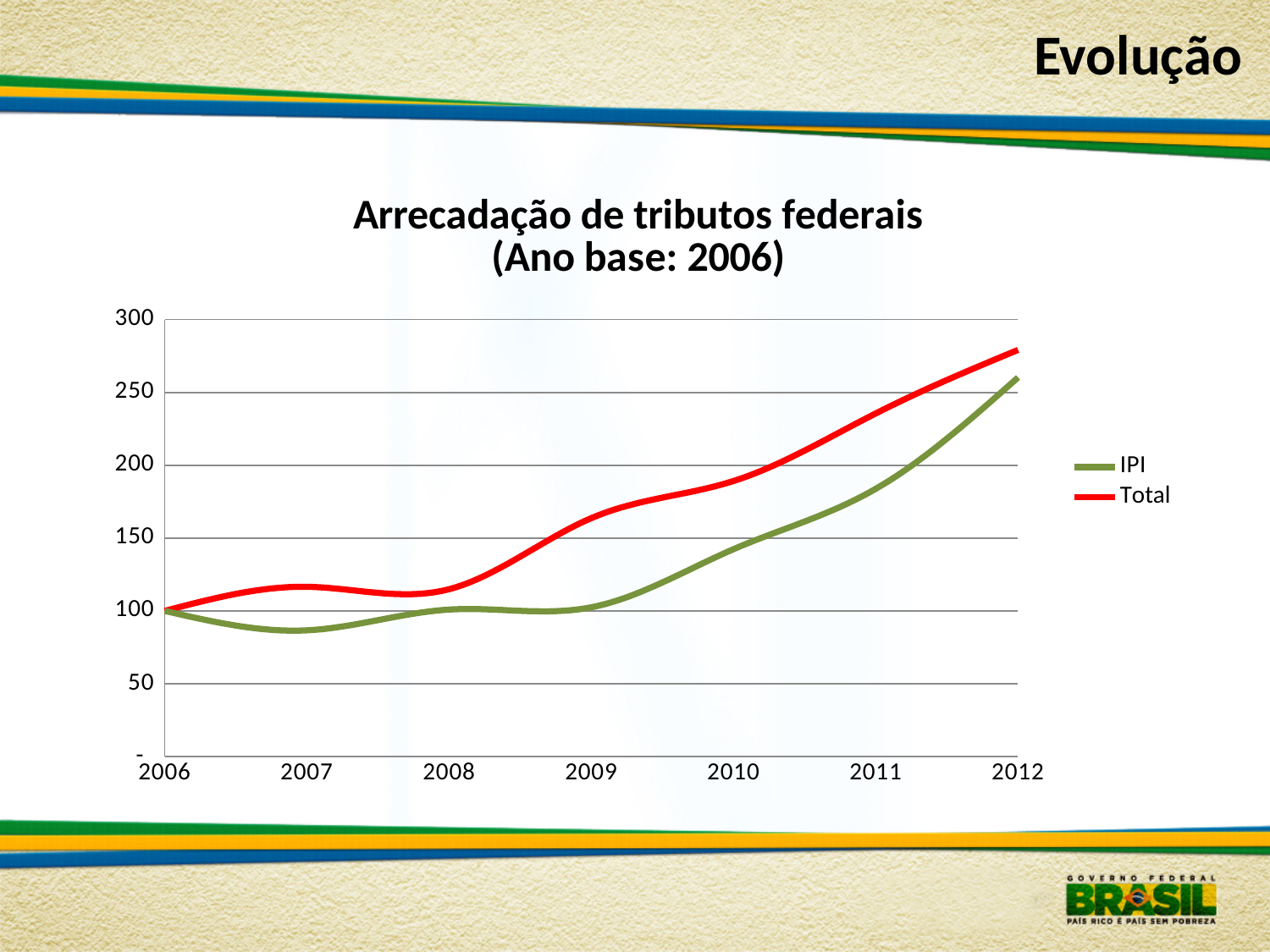
Is the value for IPI in 2007 greater or less than 100? less In which year does the IPI series reach its lowest value? 2007 In which year does the Total series reach its highest value? 2012 What is the value of the IPI series in 2006? 100 How many years are plotted along the x axis? 7 What kind of chart is shown on the slide? line chart Does the Total series generally rise or fall from 2006 to 2012? rise Which series has the larger value in 2011, IPI or Total? Total What is the value of the Total series in 2006? 100 How many series does the legend list? 2 Is the value for Total in 2012 greater or less than 250? greater Is the value for Total in 2009 greater or less than 150? greater